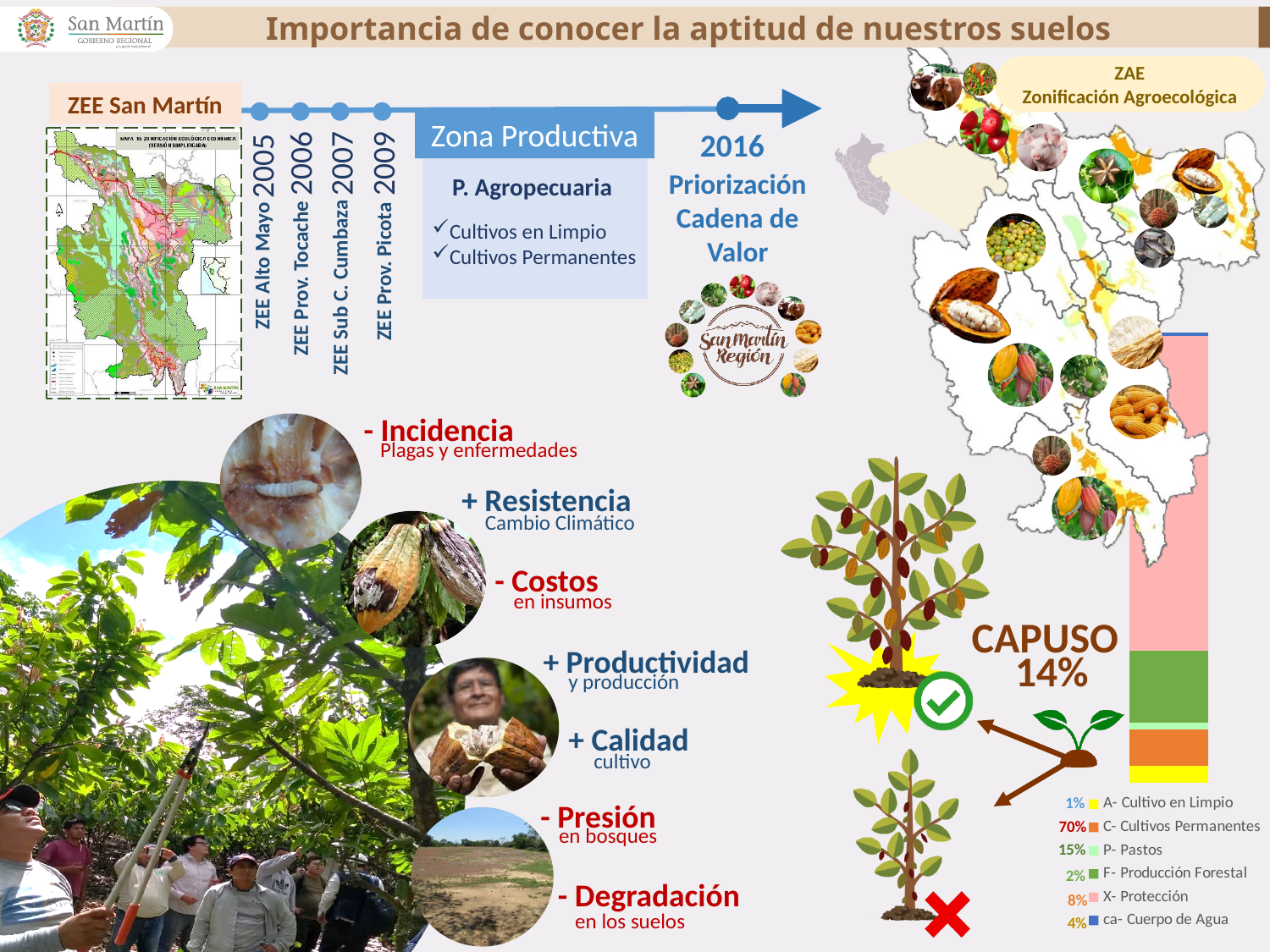
What is the total of all the percentages listed in the chart legend? 100% Which has a larger percentage, X- Protección or ca- Cuerpo de Agua? X- Protección Which category has the lowest percentage in the chart legend? A- Cultivo en Limpio What percentage is shown for P- Pastos in the chart legend? 15% How many categories are listed in the chart legend? 6 Which category has the highest percentage in the chart legend? C- Cultivos Permanentes What percentage is shown for X- Protección in the chart legend? 8% What percentage is shown for A- Cultivo en Limpio in the chart legend? 1% What is the difference in percentage points between C- Cultivos Permanentes and P- Pastos? 55 What percentage is shown for ca- Cuerpo de Agua in the chart legend? 4% What kind of chart is shown on the right side of the slide? Stacked bar chart What percentage is shown for C- Cultivos Permanentes in the chart legend? 70%